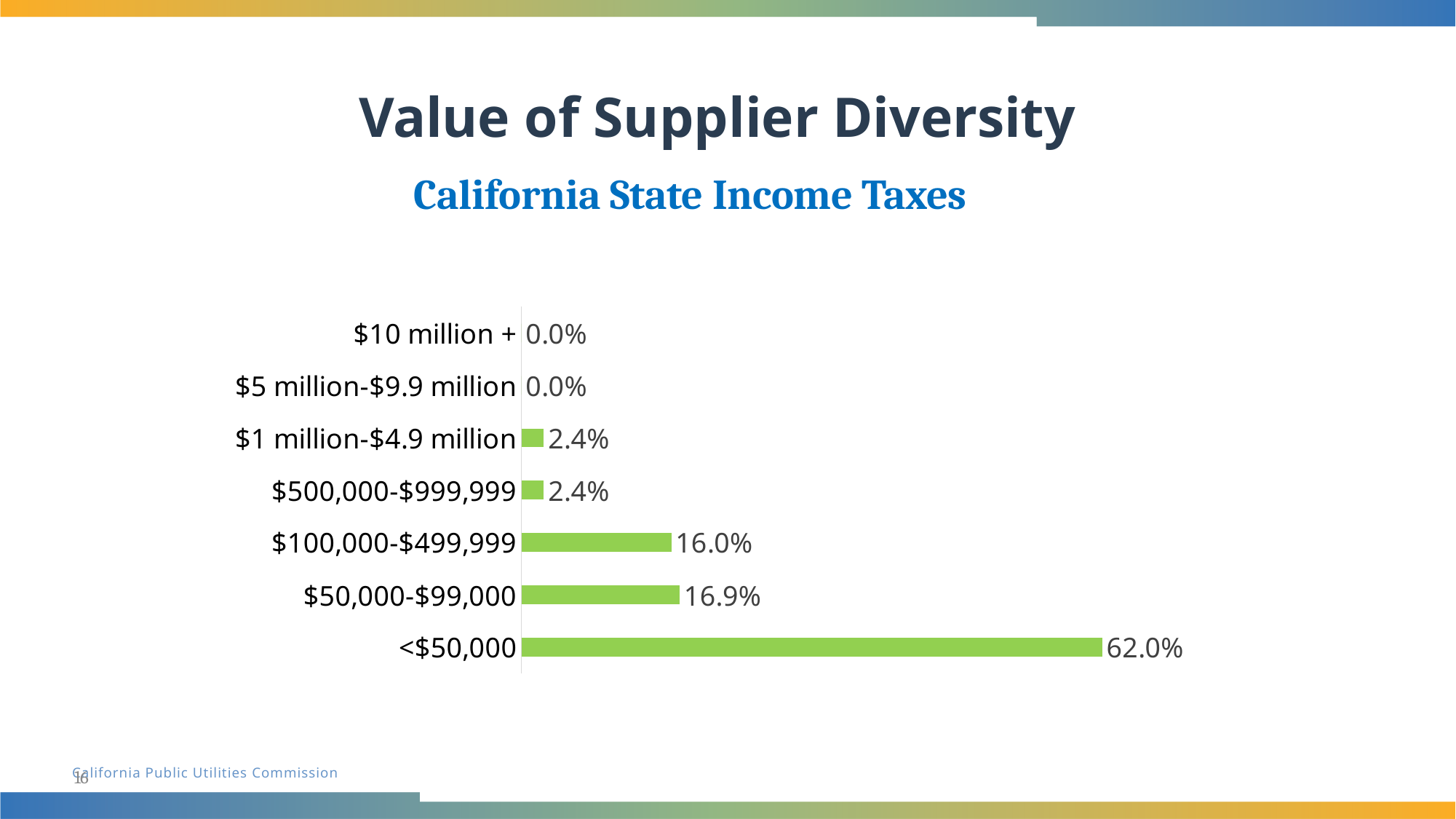
What is the value for the $10 million + category? 0.0% What is the difference between the <$50,000 value and the $50,000-$99,000 value? 45.1% What type of chart is shown on the slide? Bar chart Which category has the highest value? <$50,000 How many categories are shown in the chart? 7 What is the value for the $50,000-$99,000 category? 16.9% Which is larger: the value for $100,000-$499,999 or the value for $500,000-$999,999? $100,000-$499,999 What is the title of the chart? California State Income Taxes What is the value for the <$50,000 category? 62.0% What is the value for the $1 million-$4.9 million category? 2.4% What is the difference between the $50,000-$99,000 value and the $100,000-$499,999 value? 0.9% What is the value for the $100,000-$499,999 category? 16.0%